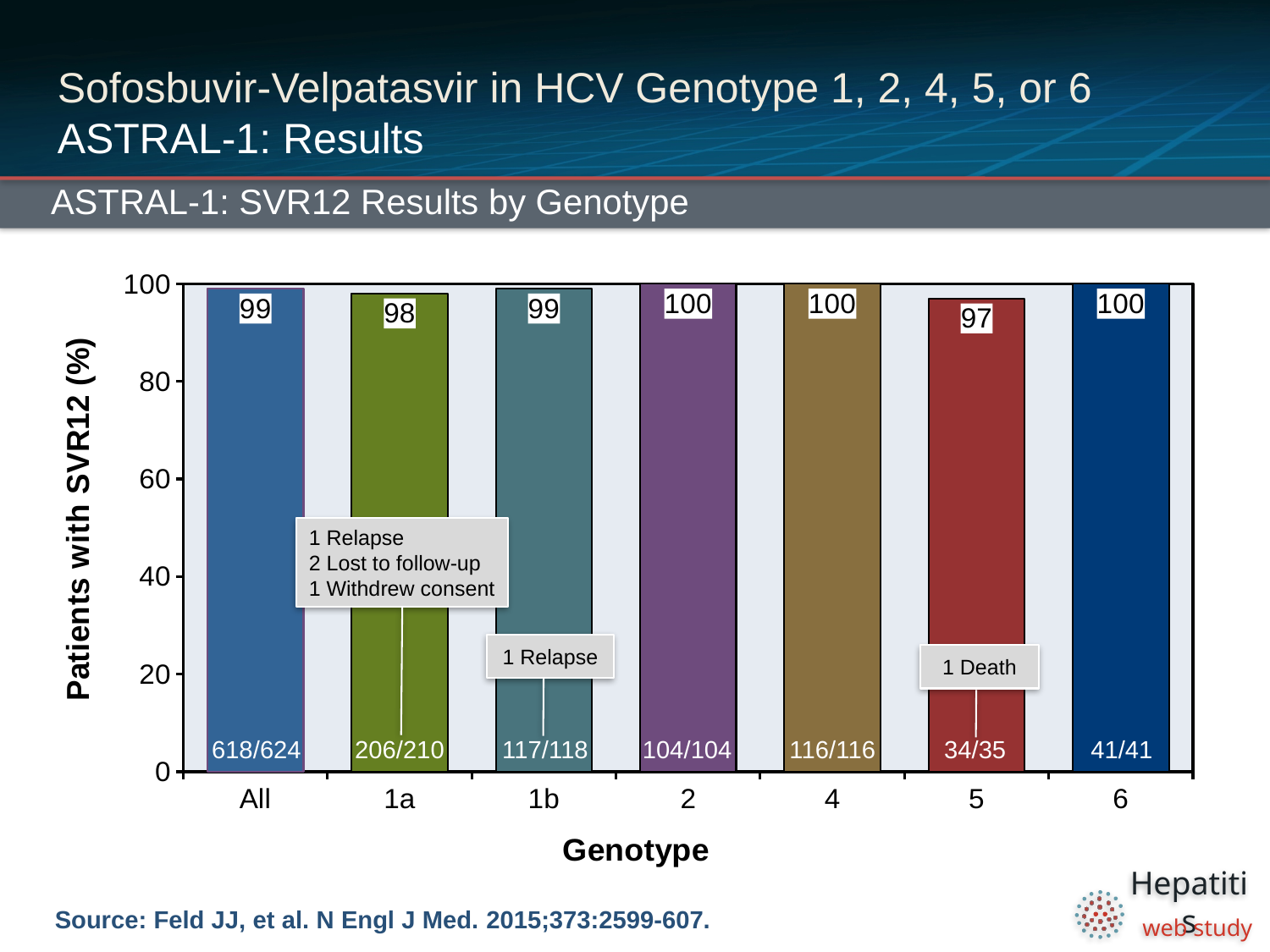
What reason is given in the annotation for the genotype 5 bar? 1 Death How many genotype categories are shown on the x axis? 7 What kind of chart is shown on the slide? Bar chart What fraction of patients is shown for genotype 1b? 117/118 How many genotypes have an SVR12 rate of 100? 3 What is the SVR12 rate for genotype 5? 97 What is the SVR12 rate for the All group? 99 What is the difference in SVR12 rate between genotype 2 and genotype 5? 3 Which genotype has the lowest SVR12 rate? 5 Which has a higher SVR12 rate, genotype 1a or genotype 1b? 1b What is the label of the y axis? Patients with SVR12 (%) What is the SVR12 rate for genotype 1a? 98